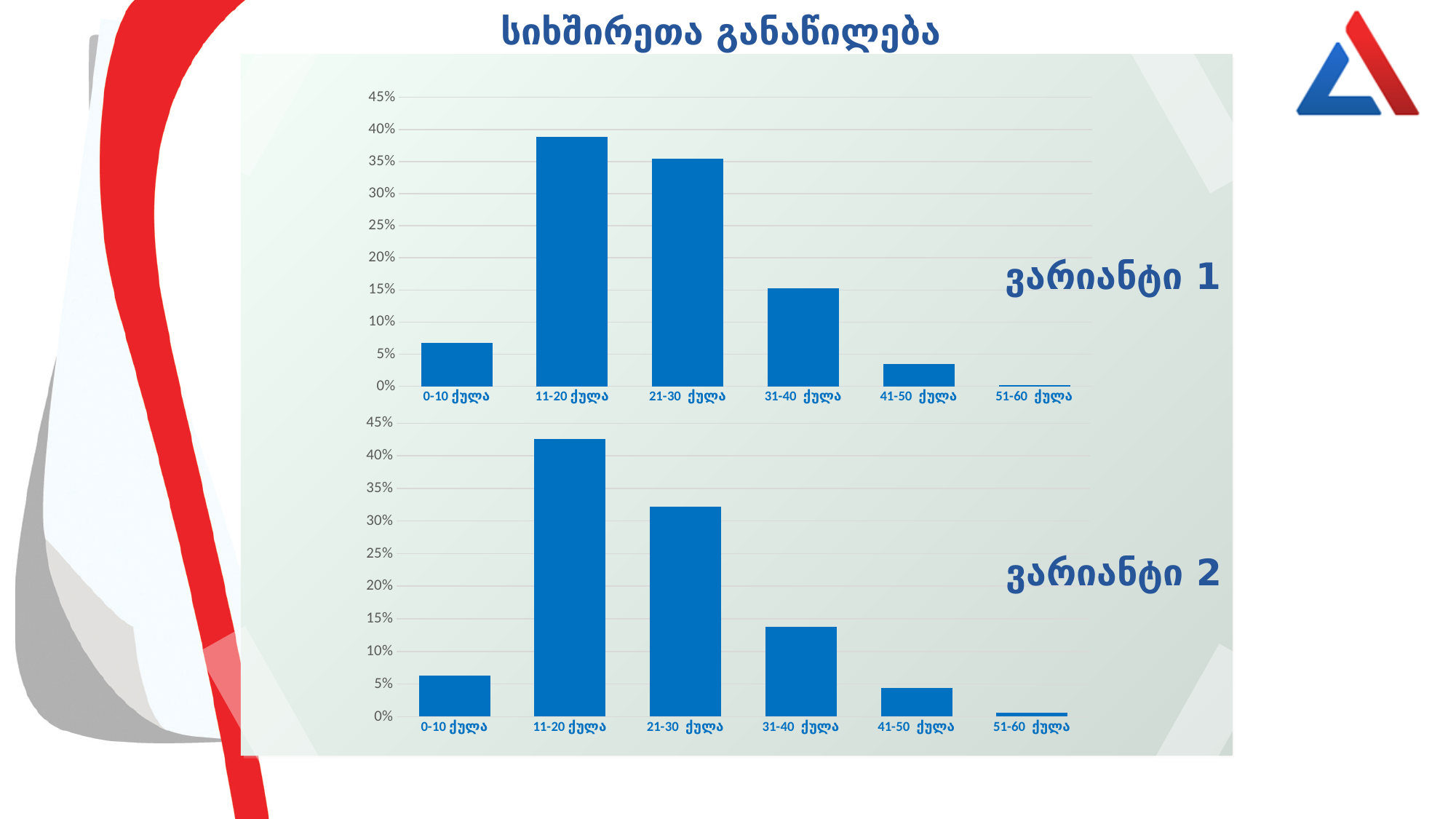
In the top chart (ვარიანტი 1), which category has the highest value? 11-20 ქულა In the bottom chart (ვარიანტი 2), is the value for 11-20 ქულა greater or less than 40%? greater In the top chart (ვარიანტი 1), is the value for 31-40 ქულა greater or less than 20%? less What is the title shown above the charts on the slide? სიხშირეთა განაწილება In the bottom chart (ვარიანტი 2), which category has the highest value? 11-20 ქულა In the top chart (ვარიანტი 1), which is larger: the value for 0-10 ქულა or the value for 41-50 ქულა? 0-10 ქულა In the top chart (ვარიანტი 1), is the value for 11-20 ქულა greater or less than 35%? greater How many categories are shown on the x axis of the top chart (ვარიანტი 1)? 6 In the bottom chart (ვარიანტი 2), which is larger: the value for 21-30 ქულა or the value for 31-40 ქულა? 21-30 ქულა What kind of chart is the top chart (ვარიანტი 1)? bar chart In the top chart (ვარიანტი 1), do the values rise or fall from 11-20 ქულა to 51-60 ქულა? fall In the top chart (ვარიანტი 1), which category has the lowest value? 51-60 ქულა